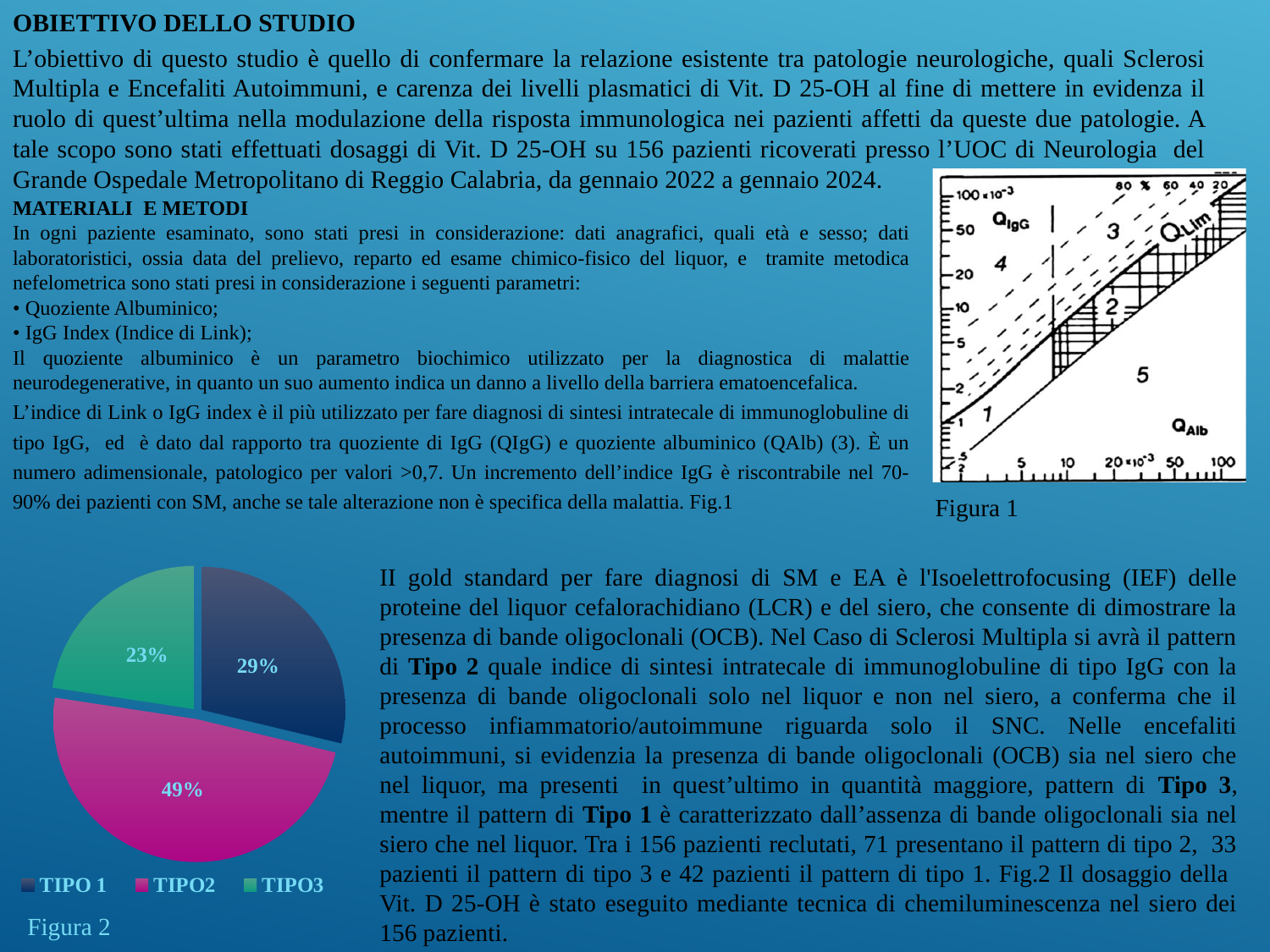
In the pie chart (Figura 2), what is the difference in percentage points between TIPO 1 and TIPO3? 6 In the pie chart (Figura 2), which category is shown in green? TIPO3 In the pie chart (Figura 2), what share is shown for TIPO3? 23% In the pie chart (Figura 2), what share is shown for TIPO 1? 29% In the pie chart (Figura 2), which category has the smallest slice? TIPO3 In the pie chart (Figura 2), what share is shown for TIPO2? 49% What type of chart is Figura 2? Pie chart In the pie chart (Figura 2), what is the difference in percentage points between TIPO2 and TIPO 1? 20 In the pie chart (Figura 2), what colour is the TIPO2 slice? Magenta/pink In the pie chart (Figura 2), which slice is larger, TIPO 1 or TIPO3? TIPO 1 How many categories does the pie chart (Figura 2) show? 3 In the pie chart (Figura 2), which category has the largest slice? TIPO2